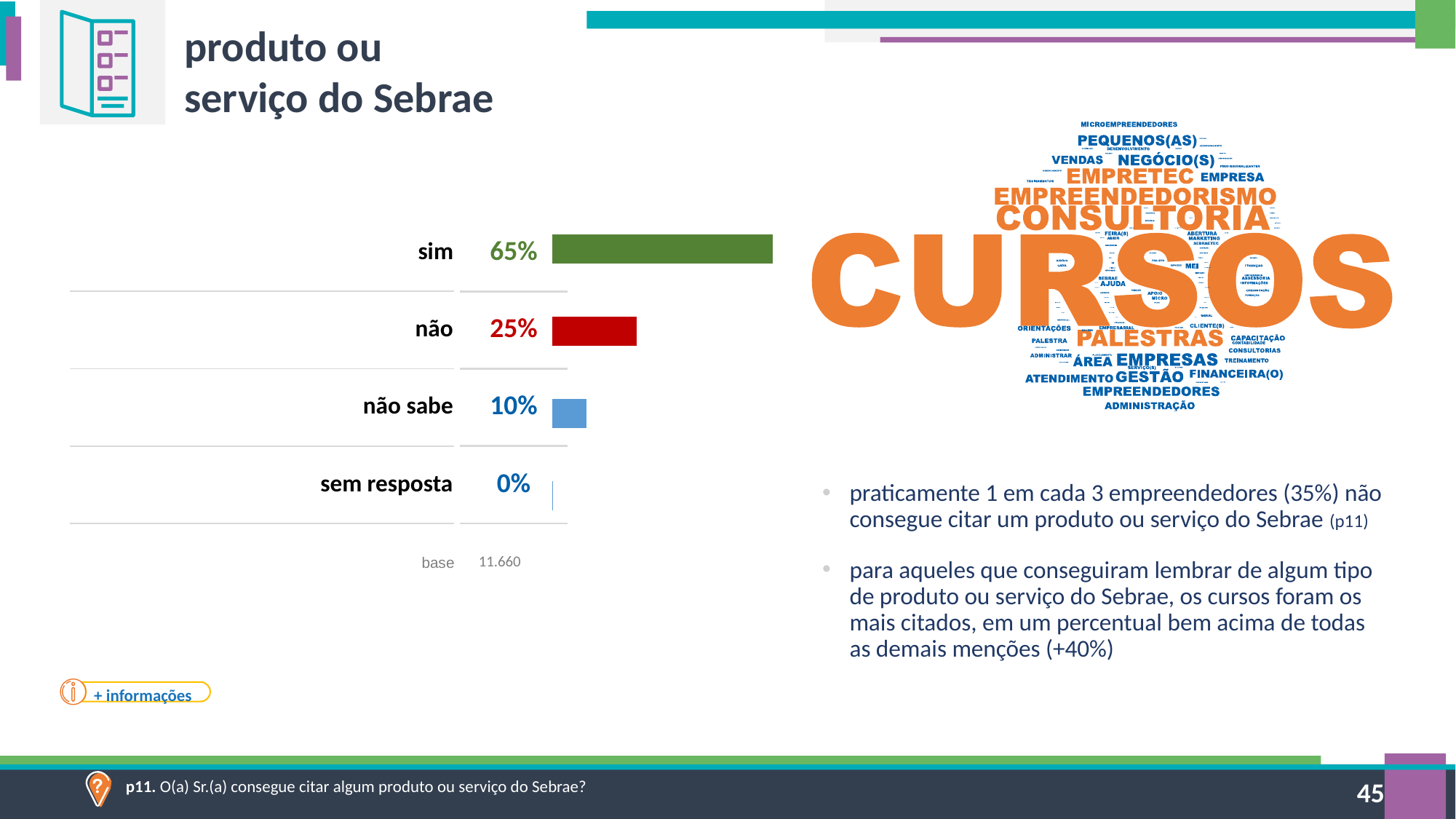
What is the value for "sem resposta"? 0% What is the value for "não"? 25% What is the value for "não sabe"? 10% How many categories does the bar chart show? 4 What kind of chart is shown on the slide? bar chart Which category has the highest value? sim Which category has the lowest value? sem resposta What is the difference between the values for "não" and "não sabe"? 15% Which is larger, the value for "não" or the value for "não sabe"? não What is the difference between the values for "sim" and "não"? 40% What is the value for "sim"? 65% What is the base (number of respondents) shown below the chart? 11.660